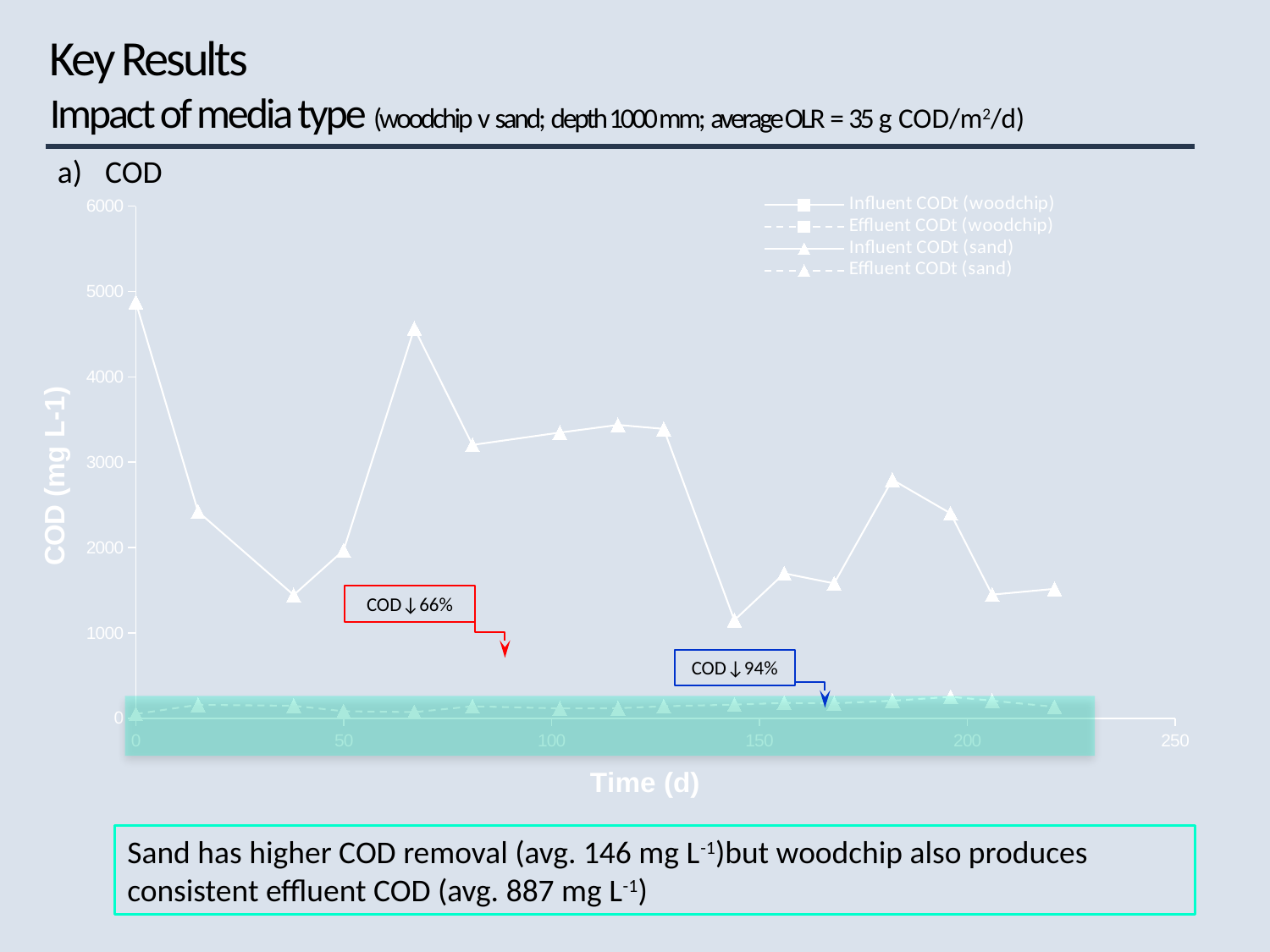
How many series does the chart legend list? 4 What kind of chart is shown on the slide? line chart What COD reduction percentage is shown in the red annotation box? 66% Is the Influent CODt (sand) value around day 180 greater or less than 2000? greater Does the Influent CODt (sand) series overall rise or fall from day 0 to the last point around day 220? fall Is the Influent CODt (sand) value at the peak around day 65 greater or less than 4000? greater At which time does the Influent CODt (sand) series reach its highest value? 0 d Which is larger for Influent CODt (sand): the value at day 0 or the value around day 140? day 0 What COD reduction percentage is shown in the blue annotation box? 94% Is the Influent CODt (sand) value at time 0 d greater or less than 4000? greater